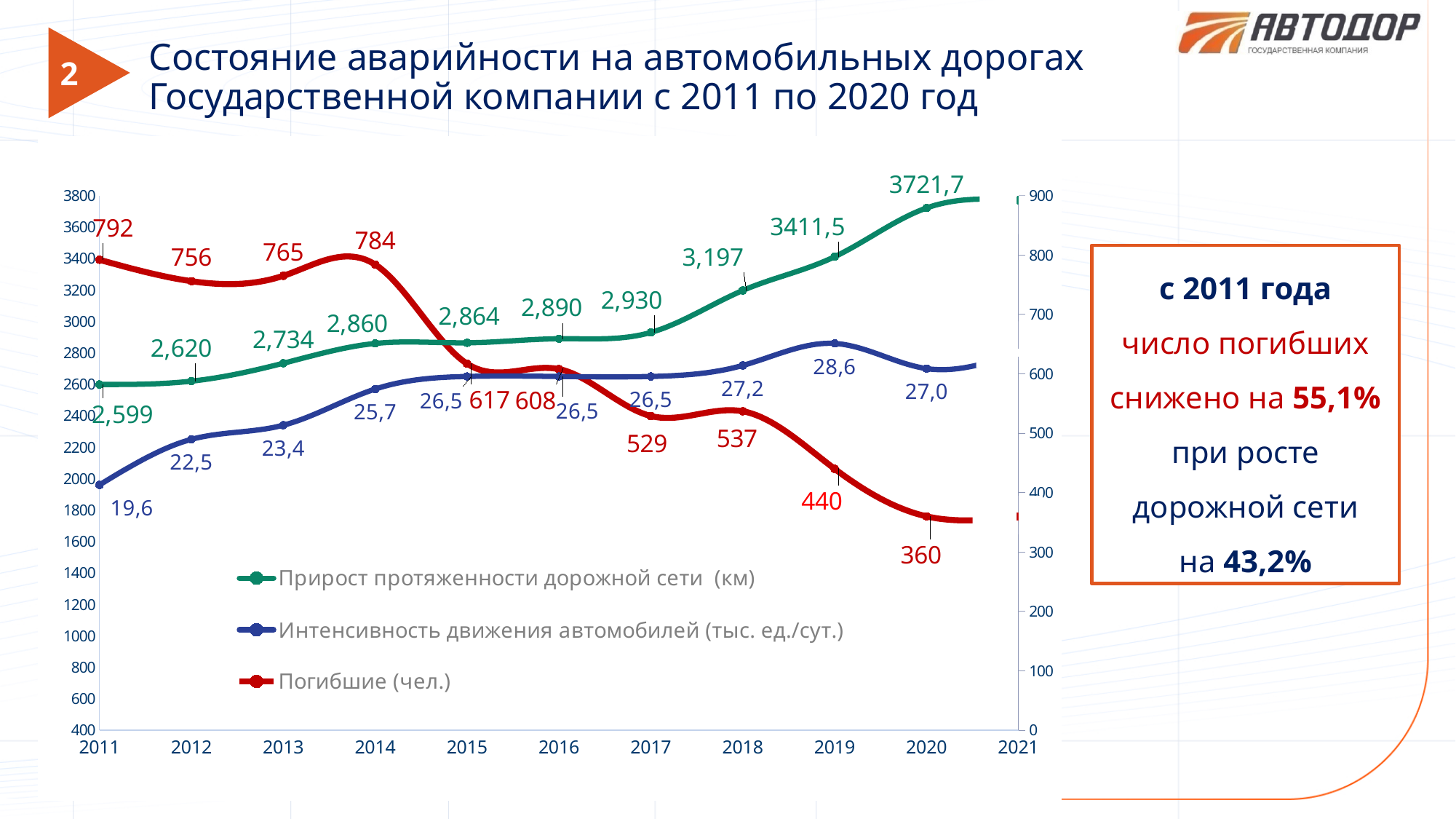
What kind of chart is shown on the slide? line chart What is the value of the 'Погибшие (чел.)' series in 2017? 529 What is the value of the 'Прирост протяженности дорожной сети (км)' series in 2020? 3721,7 Which year has a higher 'Погибшие (чел.)' value, 2014 or 2015? 2014 In which year is the 'Интенсивность движения автомобилей (тыс. ед./сут.)' series at its highest? 2019 What is the value of the 'Интенсивность движения автомобилей (тыс. ед./сут.)' series in 2014? 25,7 What is the value of the 'Погибшие (чел.)' series in 2011? 792 What is the difference between the 'Погибшие (чел.)' values in 2011 and 2020? 432 How many series does the legend list? 3 Does the 'Погибшие (чел.)' series generally rise or fall from 2011 to 2020? fall In which year is the 'Погибшие (чел.)' series at its lowest? 2020